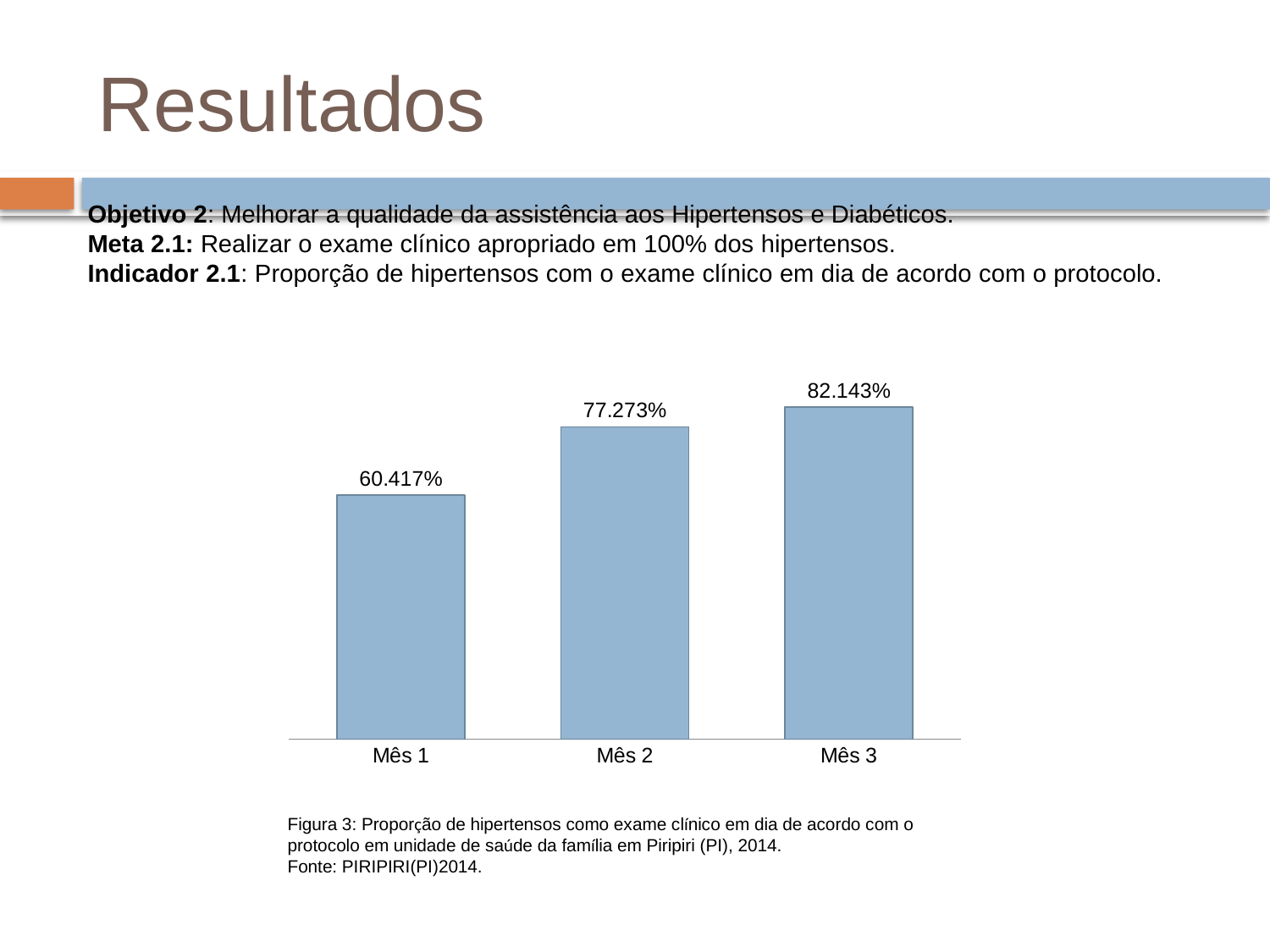
How many months are shown on the chart? 3 Which month has the lowest value? Mês 1 Which is larger, the value for Mês 2 or the value for Mês 3? Mês 3 What is the figure number given in the caption below the chart? Figura 3 What kind of chart is shown on the slide? Bar chart What is the value for Mês 3? 82.143% What is the difference between the values for Mês 2 and Mês 1? 16.856% Do the values rise or fall from Mês 1 to Mês 3? Rise What is the difference between the values for Mês 3 and Mês 1? 21.726% What is the value for Mês 2? 77.273% What is the value for Mês 1? 60.417% Which month has the highest value? Mês 3